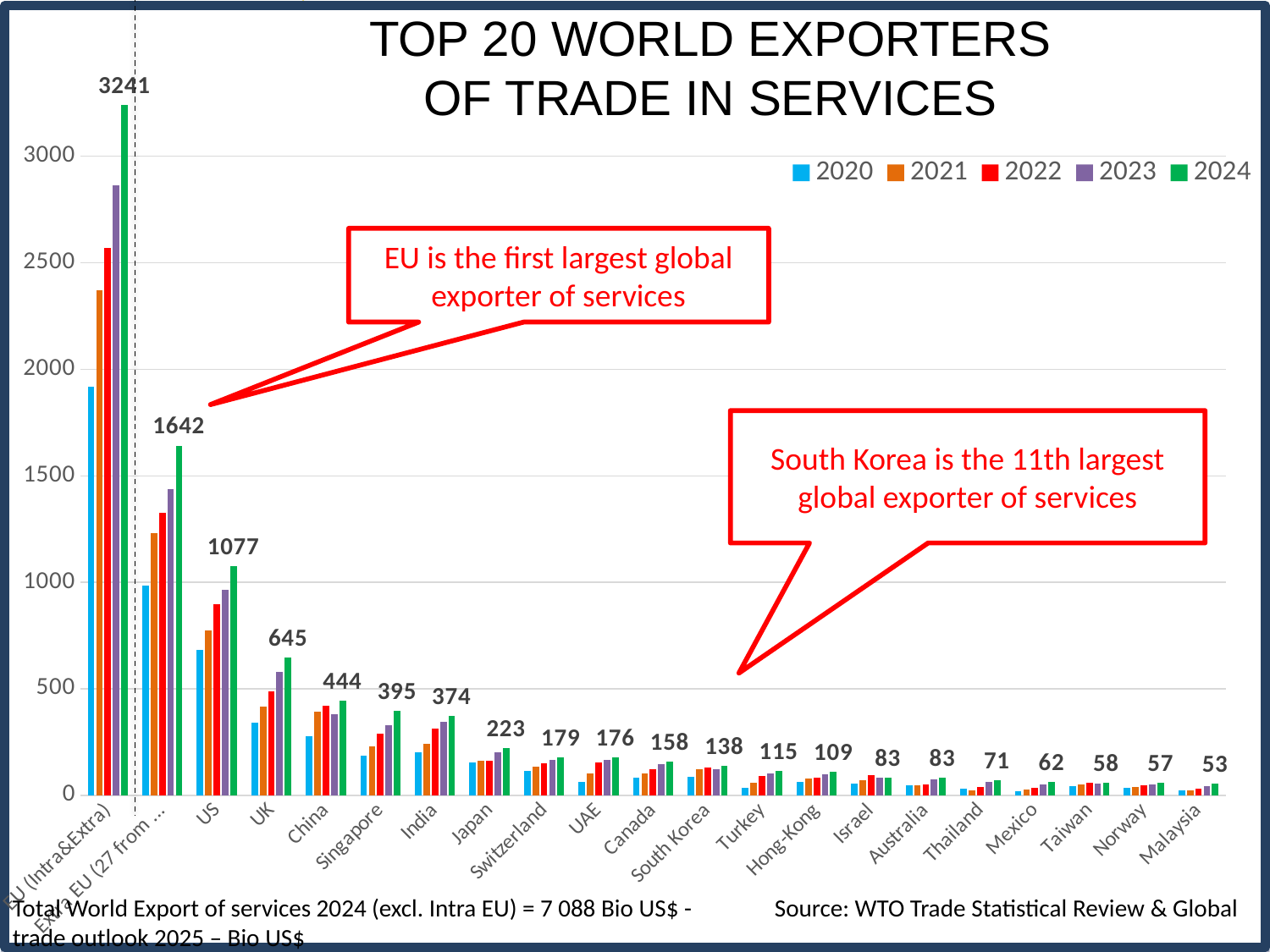
Which category has the highest 2024 value? EU (Intra&Extra) What is the difference between the 2024 values for the UK and China? 201 How many series does the legend list? 5 Which has the larger 2024 value, Japan or Switzerland? Japan What is the 2024 value labelled for Singapore? 395 Which category has the lowest 2024 value? Malaysia Do the 2024 values rise or fall moving from left to right along the x axis? Fall What kind of chart is shown? Bar chart What is the 2024 value labelled for the US? 1077 Is the 2020 value for the US greater or less than 500? greater Which colour represents the 2024 series in the legend? Green What is the 2024 value labelled for South Korea? 138